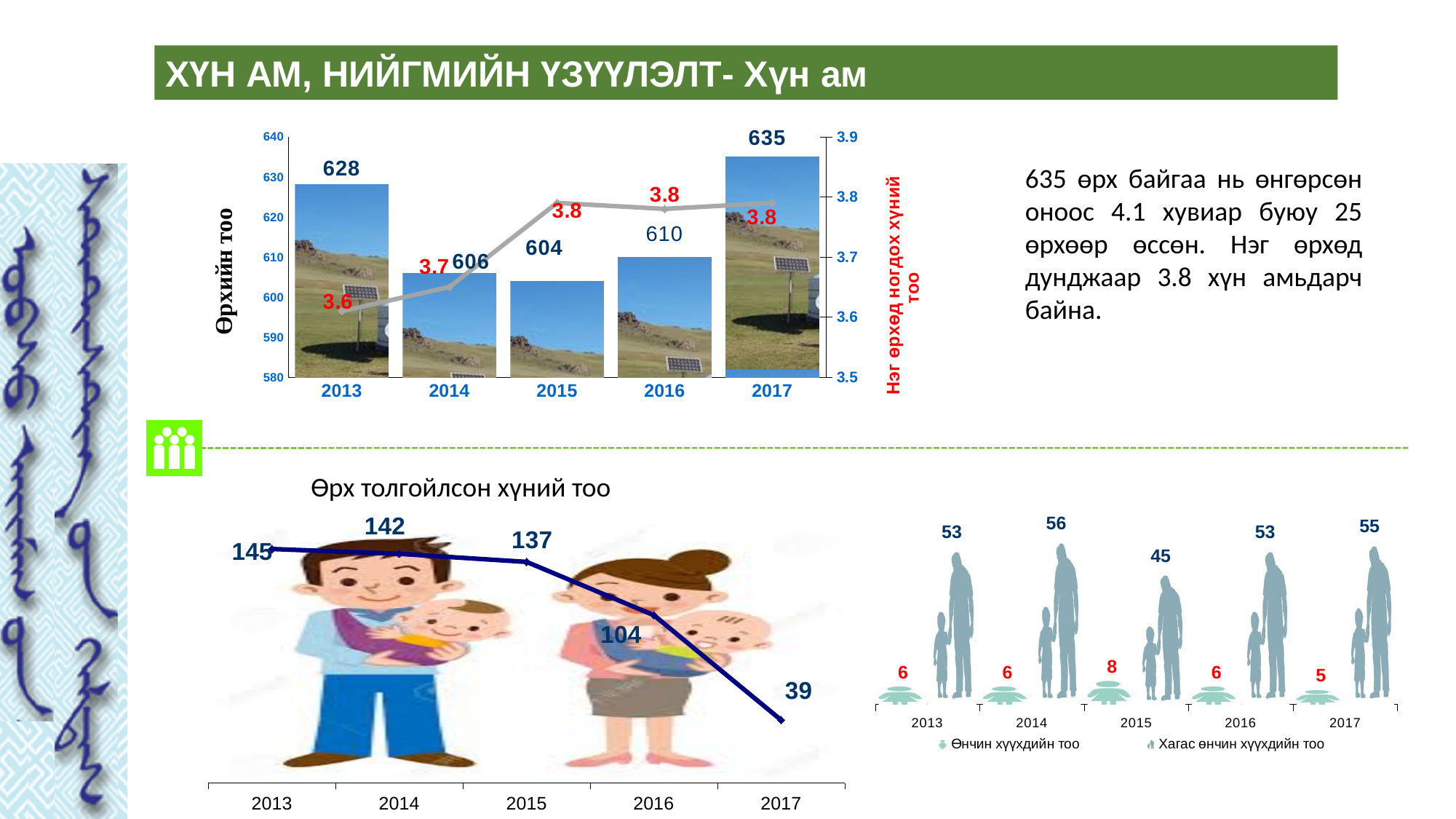
In the top chart, which year has the lowest number of households? 2015 In the bottom-right chart, what is the value of 'Хагас өнчин хүүхдийн тоо' in 2014? 56 In the bottom-left chart 'Өрх толгойлсон хүний тоо', do the values rise or fall from 2013 to 2017? fall In the bottom-left chart 'Өрх толгойлсон хүний тоо', what is the difference between the 2013 value and the 2017 value? 106 In the bottom-right chart, which year has the highest value of 'Өнчин хүүхдийн тоо'? 2015 In the top chart, what is the number of households (Өрхийн тоо) in 2017? 635 In the top chart, what is the difference between the number of households in 2017 and in 2013? 7 In the bottom-right chart, how many series does the legend list? 2 In the top chart, what is the average number of persons per household (Нэг өрхөд ногдох хүний тоо) in 2013? 3.6 In the bottom-right chart, which is larger: 'Хагас өнчин хүүхдийн тоо' in 2015 or in 2017? 2017 In the bottom-left chart 'Өрх толгойлсон хүний тоо', what is the value for 2016? 104 In the top chart, how many years are shown on the x axis? 5